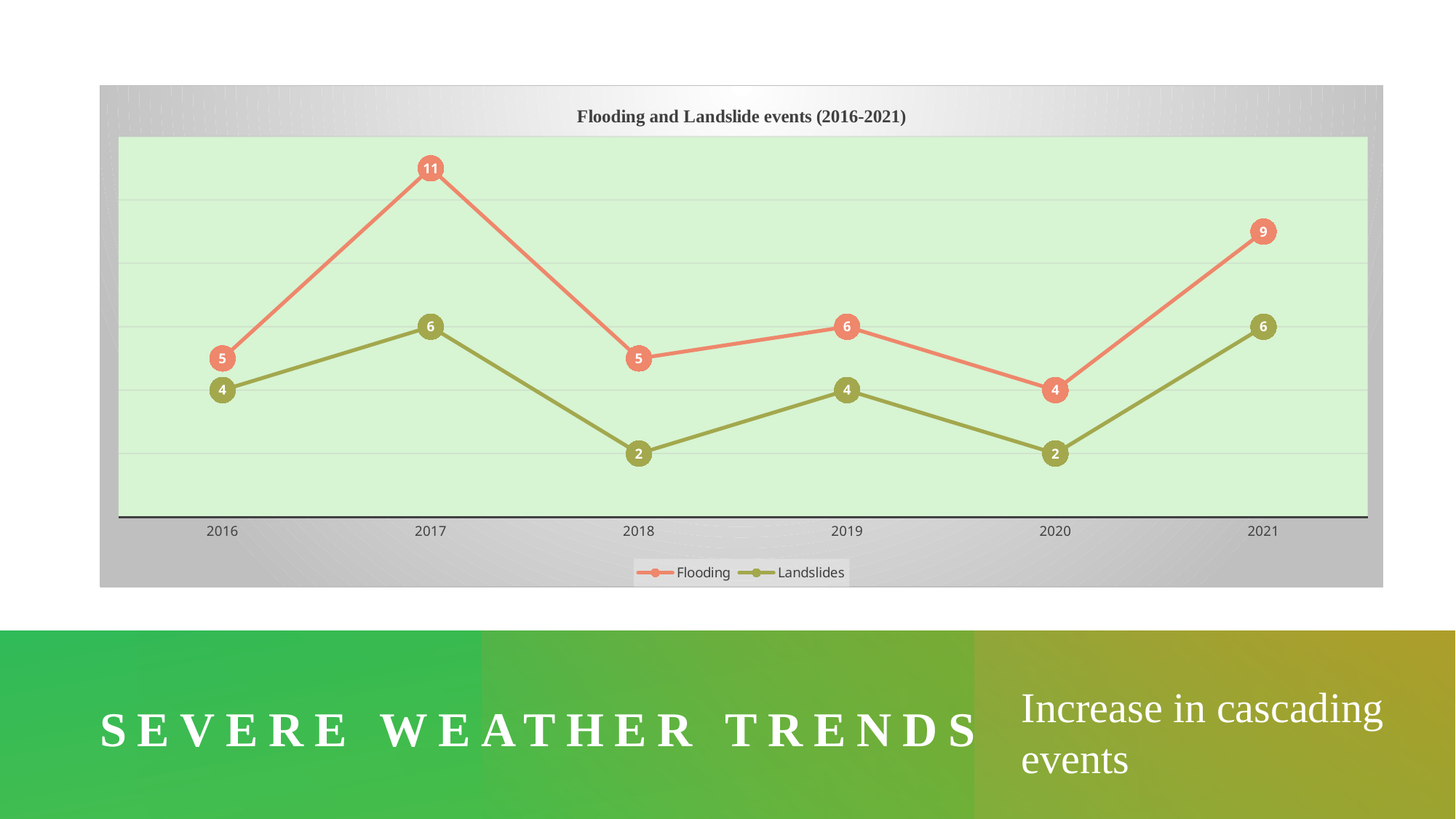
How many years are shown on the x axis? 6 How many series does the legend list? 2 What is the Landslides value for 2020? 2 In which year is the Flooding value highest? 2017 In which year is the Flooding value lowest? 2020 What kind of chart is shown on the slide? line chart What is the difference between the Flooding and Landslides values in 2017? 5 What is the Flooding value for 2017? 11 What is the title of the chart? Flooding and Landslide events (2016-2021) What is the difference between the Flooding values for 2021 and 2020? 5 Which is larger, the Landslides value for 2019 or for 2018? 2019 What is the Flooding value for 2021? 9